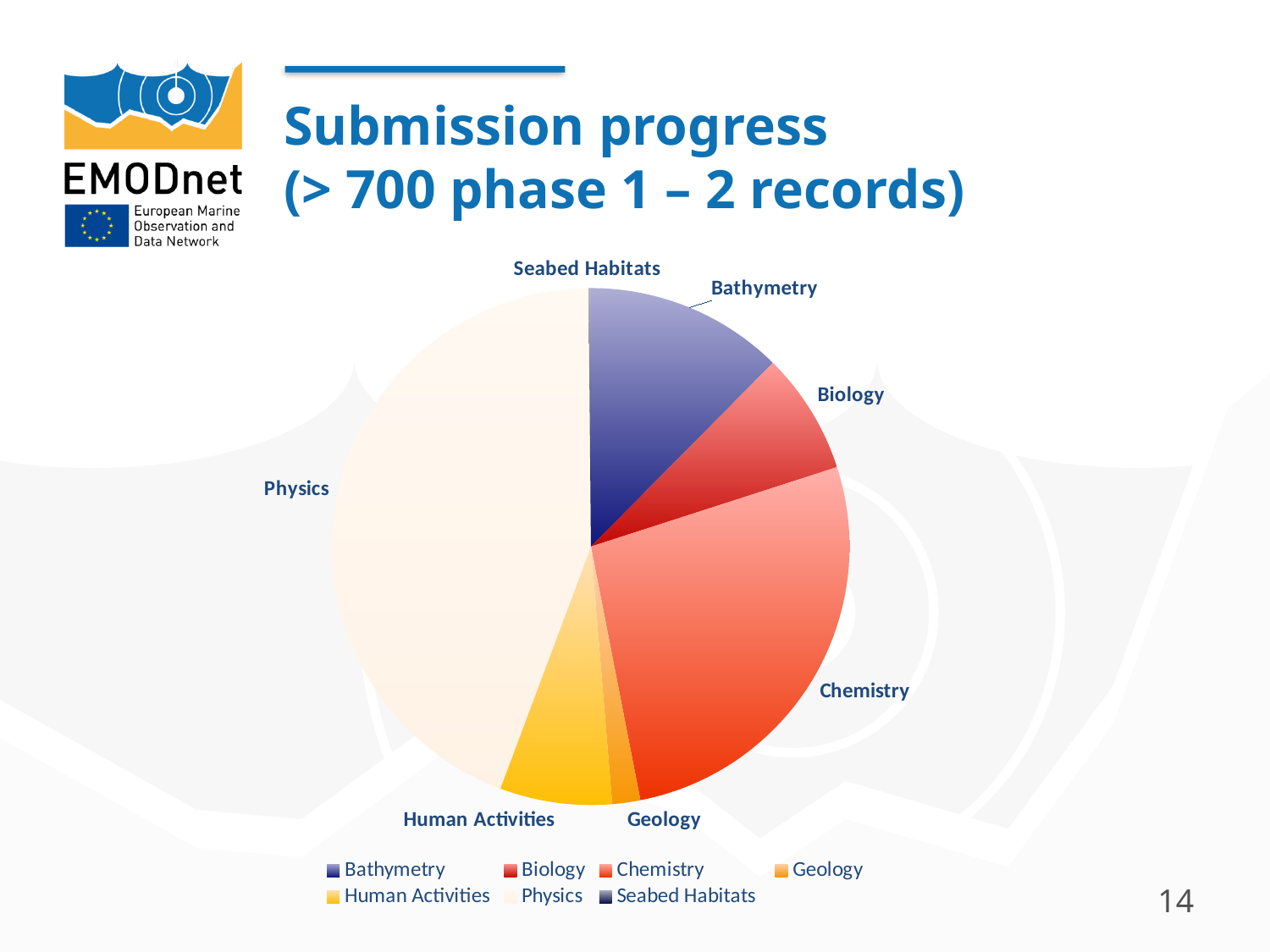
Which category has the largest slice of the pie chart? Physics Which slice is larger, Chemistry or Biology? Chemistry How many entries does the legend of the pie chart list? 7 Which slice is larger, Physics or Chemistry? Physics Which slice is larger, Geology or Chemistry? Chemistry What is the title of the slide containing the pie chart? Submission progress (> 700 phase 1 – 2 records) What kind of chart is shown on the slide? Pie chart How many categories (slices) does the pie chart have? 7 Which category is listed first in the legend of the pie chart? Bathymetry